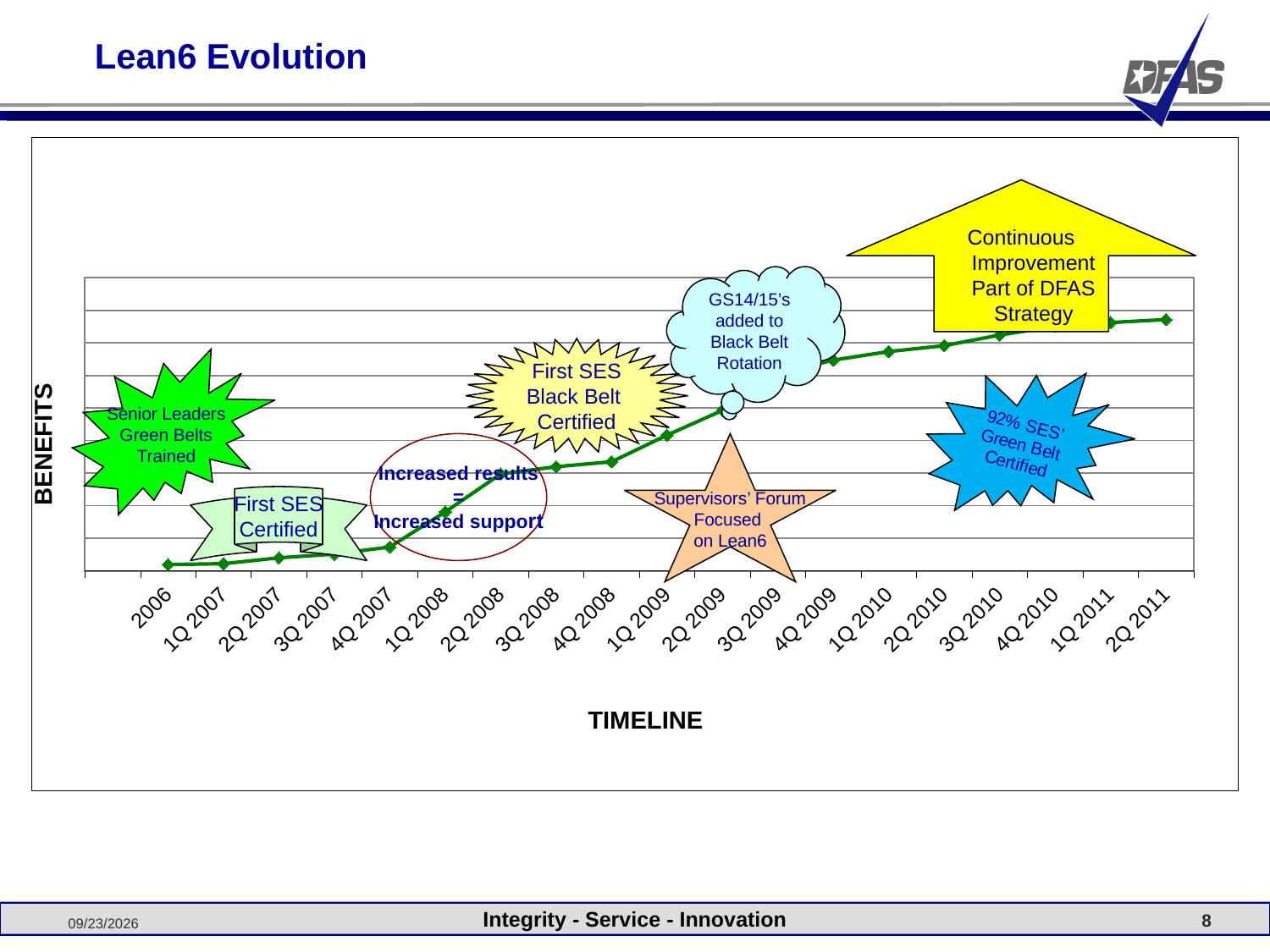
What is the first time period labelled on the x axis? 2006 How many time periods are labelled on the x axis of the chart? 19 Do the plotted values rise or fall along the x axis from 2006 to 2Q 2011? Rise What kind of chart is shown on the slide? Line chart Which is larger, the value for 2Q 2011 or the value for 2006? 2Q 2011 Which is larger, the value for 1Q 2009 or the value for 2Q 2008? 1Q 2009 What is the label of the horizontal axis of the chart? TIMELINE Which time period has the highest plotted value? 2Q 2011 Which is larger, the value for 4Q 2009 or the value for 3Q 2007? 4Q 2009 What is the last time period labelled on the x axis? 2Q 2011 What is the label of the vertical axis of the chart? BENEFITS